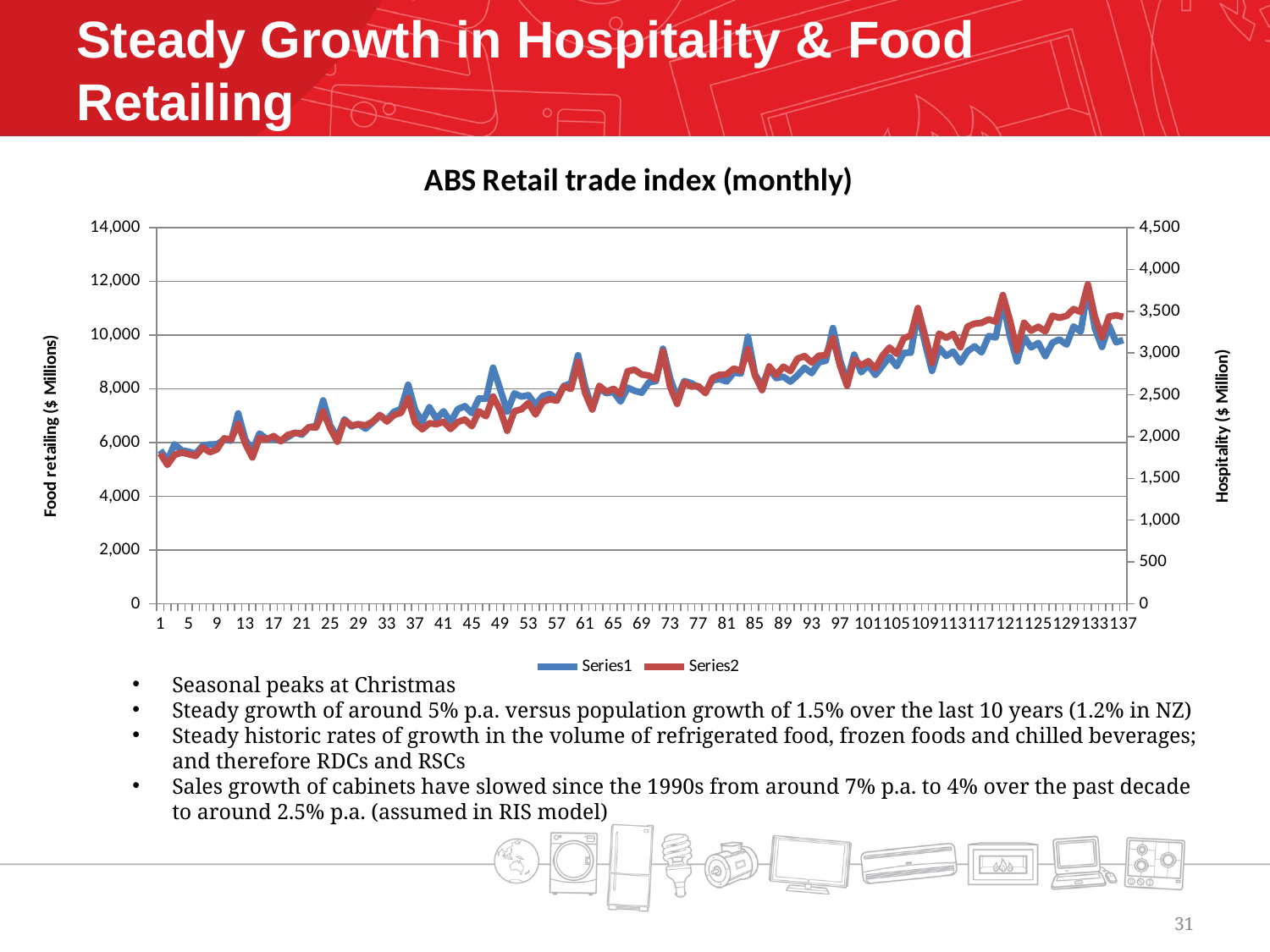
How many series does the legend list? 2 What is the label of the right vertical axis? Hospitality ($ Million) What is the highest tick value shown on the right vertical axis? 4,500 What are the names of the two series in the legend? Series1 and Series2 Do the values of Series2 generally rise or fall along the x axis? Rise What kind of chart is shown on the slide? Line chart Do the values of Series1 generally rise or fall along the x axis? Rise